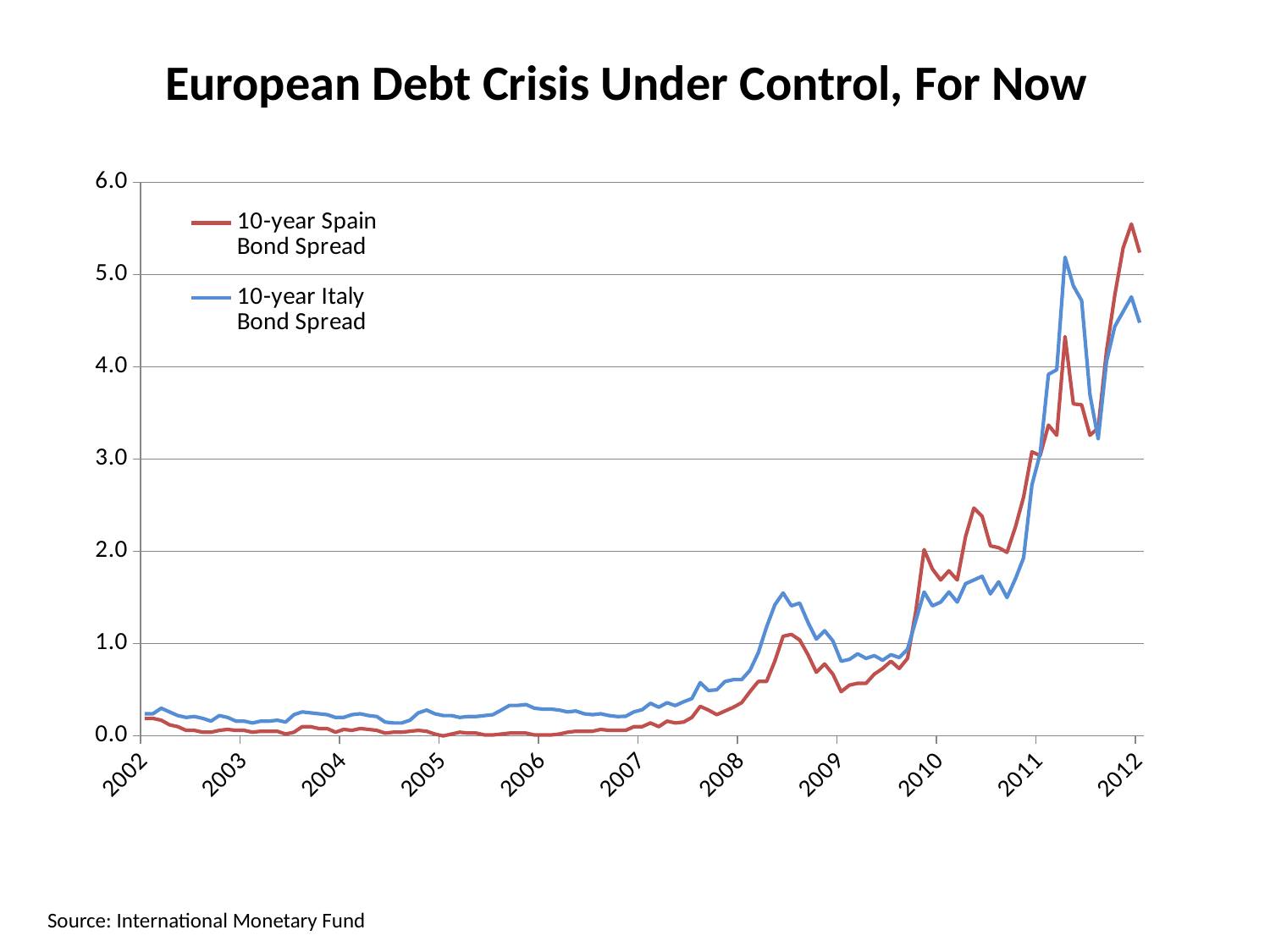
Do the bond spread values generally rise or fall from 2002 to 2012? rise What kind of chart is shown on the slide? line chart Is the peak value of the 10-year Italy Bond Spread in 2011 greater or less than 4.0? greater Is the value for the 10-year Spain Bond Spread at 2006 greater or less than 1.0? less At 2012, which series is higher, the 10-year Spain Bond Spread or the 10-year Italy Bond Spread? 10-year Spain Bond Spread Around mid-2008, which series is higher, the 10-year Spain Bond Spread or the 10-year Italy Bond Spread? 10-year Italy Bond Spread How many series does the legend list? 2 How many year labels are shown on the x axis? 11 What source is cited for the chart data? International Monetary Fund Is the value for the 10-year Italy Bond Spread at 2012 greater or less than 5.0? less What is the title of the chart? European Debt Crisis Under Control, For Now